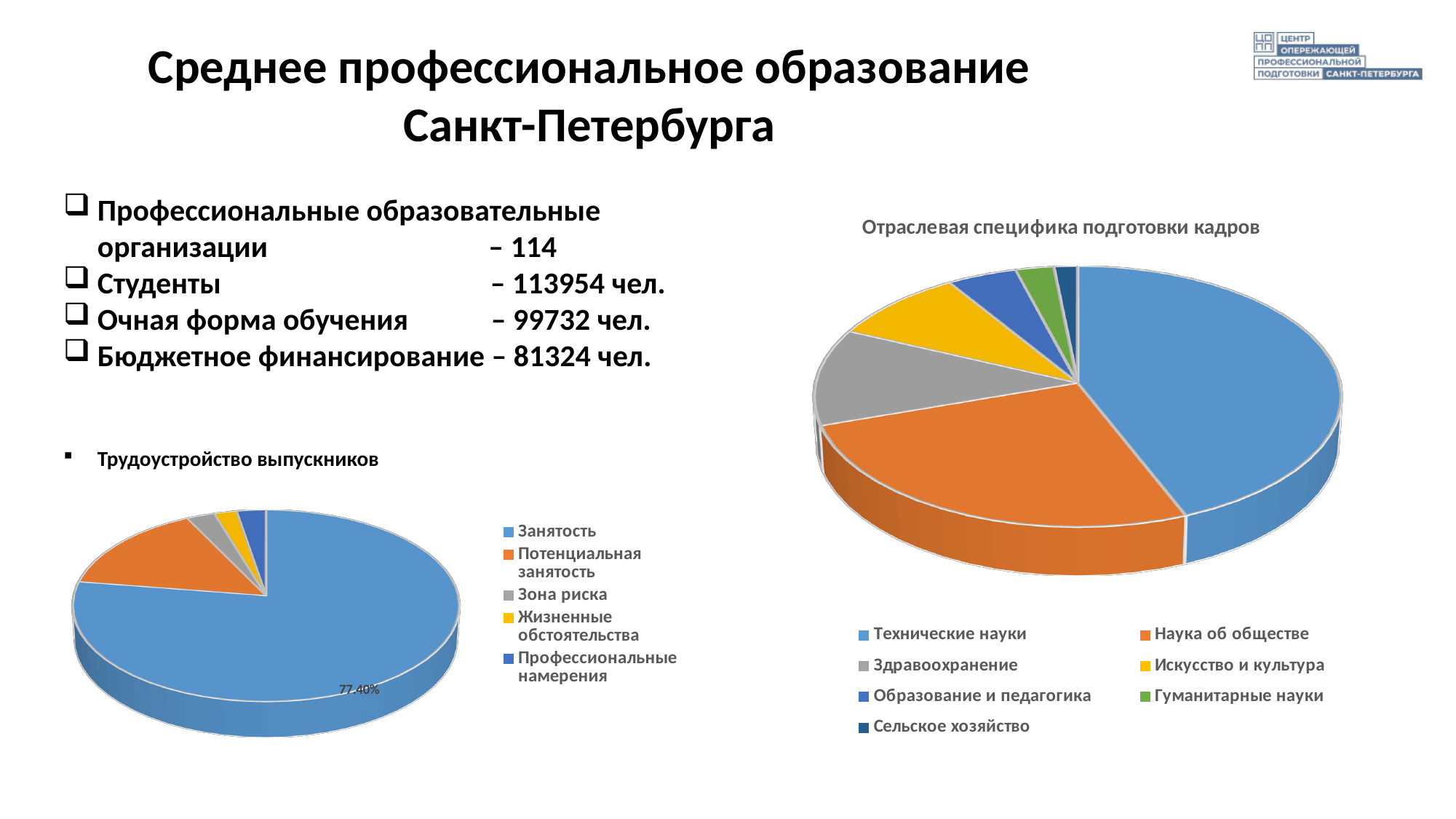
In the 'Трудоустройство выпускников' chart, which slice is larger: Потенциальная занятость or Зона риска? Потенциальная занятость How many categories does the legend of the 'Трудоустройство выпускников' chart list? 5 In the 'Отраслевая специфика подготовки кадров' chart, which slice is larger: Технические науки or Наука об обществе? Технические науки In the 'Отраслевая специфика подготовки кадров' chart, what colour is the Искусство и культура slice? yellow In the 'Трудоустройство выпускников' chart, what share does Занятость have? 77.40% In the 'Отраслевая специфика подготовки кадров' chart, which category has the largest slice? Технические науки What is the title of the pie chart on the right side of the slide? Отраслевая специфика подготовки кадров What kind of chart is the 'Трудоустройство выпускников' chart? pie chart In the 'Трудоустройство выпускников' chart, which category has the largest slice? Занятость What kind of chart is the 'Отраслевая специфика подготовки кадров' chart? pie chart How many categories does the legend of the 'Отраслевая специфика подготовки кадров' chart list? 7 In the 'Отраслевая специфика подготовки кадров' chart, which slice is larger: Наука об обществе or Здравоохранение? Наука об обществе